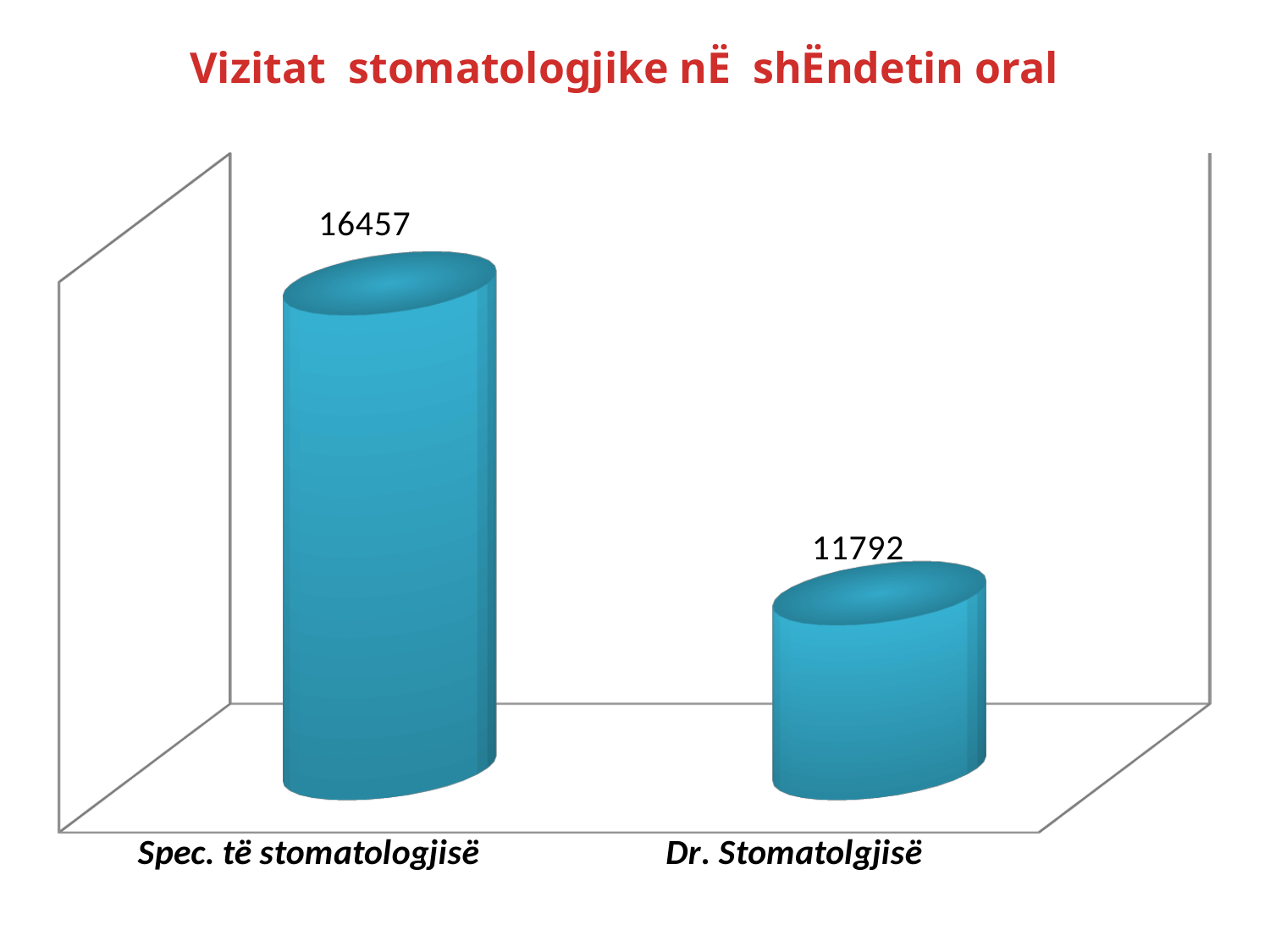
Which is larger, the value for Spec. të stomatologjisë or the value for Dr. Stomatolgjisë? Spec. të stomatologjisë Which category has the highest value? Spec. të stomatologjisë How many categories are shown in the chart? 2 What is the value for Spec. të stomatologjisë? 16457 What is the difference between the values for Spec. të stomatologjisë and Dr. Stomatolgjisë? 4665 What kind of chart is shown on the slide? Bar chart What is the title of the chart? Vizitat stomatologjike nË shËndetin oral What colour are the bars in the chart? Blue What is the value for Dr. Stomatolgjisë? 11792 Which category has the lowest value? Dr. Stomatolgjisë What is the total of the two values shown in the chart? 28249